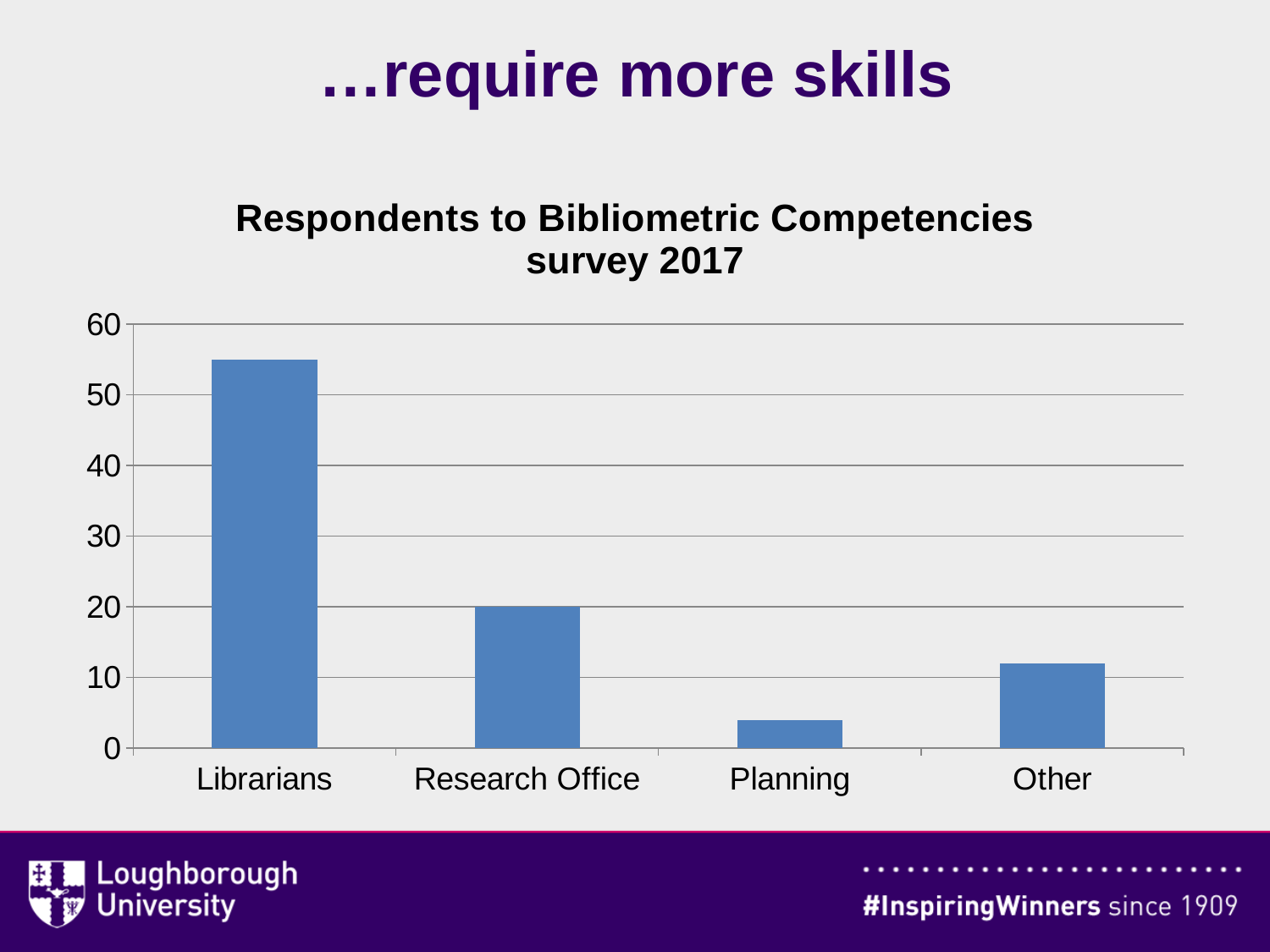
Which is larger, the value for Research Office or the value for Other? Research Office Is the value for Planning greater or less than 10? less What is the value for Research Office? 20 What kind of chart is shown on the slide? bar chart What is the highest value shown on the y axis of the chart? 60 Which is larger, the value for Planning or the value for Other? Other Is the value for Librarians greater or less than 50? greater Which category has the highest number of respondents? Librarians How many categories are shown on the x axis of the chart? 4 Which category has the lowest number of respondents? Planning What is the title of the chart? Respondents to Bibliometric Competencies survey 2017 Is the value for Other greater or less than 10? greater